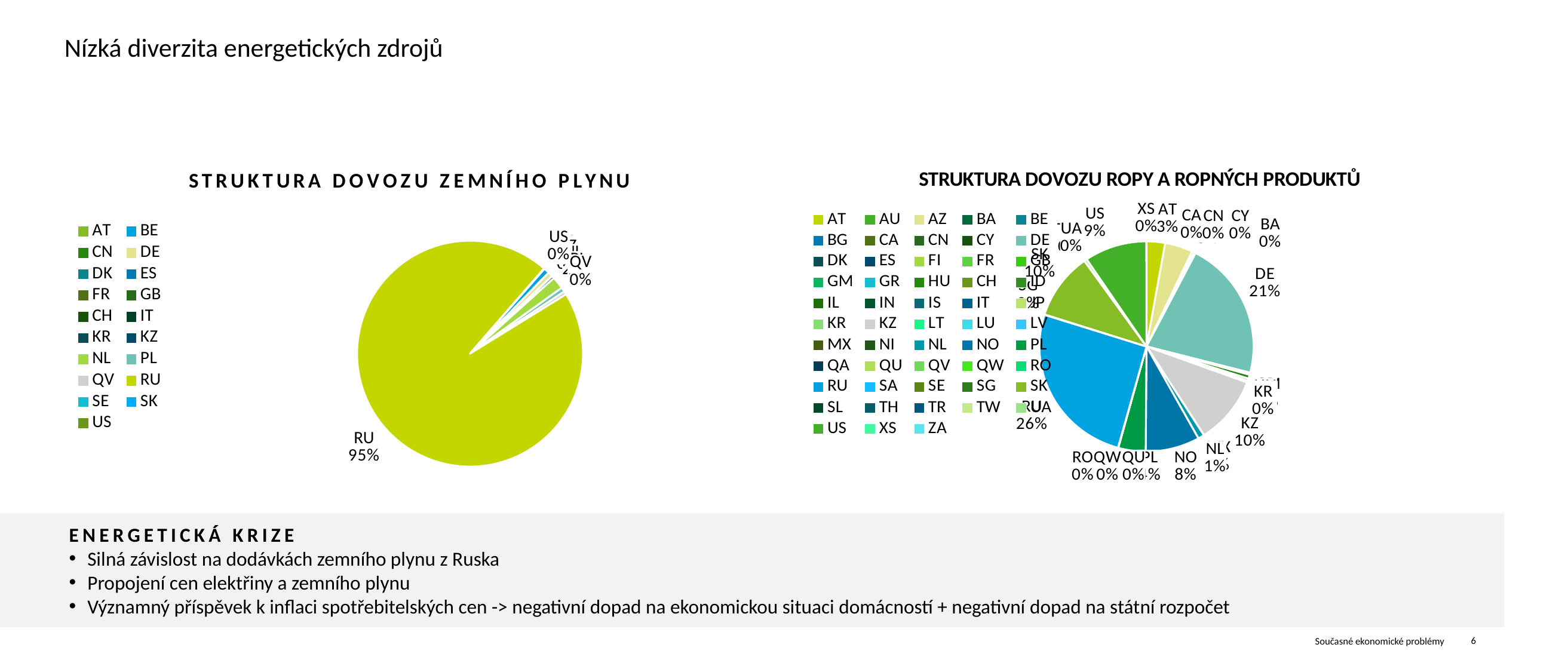
In the chart titled STRUKTURA DOVOZU ZEMNÍHO PLYNU, what share of the pie does RU have? 95% In the chart titled STRUKTURA DOVOZU ROPY A ROPNÝCH PRODUKTŮ, what share does US have? 9% What kind of chart is the left chart, STRUKTURA DOVOZU ZEMNÍHO PLYNU? Pie chart In the chart titled STRUKTURA DOVOZU ROPY A ROPNÝCH PRODUKTŮ, what share does NO have? 8% In the chart titled STRUKTURA DOVOZU ROPY A ROPNÝCH PRODUKTŮ, what share does DE have? 21% How many entries does the legend of the chart STRUKTURA DOVOZU ZEMNÍHO PLYNU list? 19 In the chart titled STRUKTURA DOVOZU ROPY A ROPNÝCH PRODUKTŮ, what share does RU have? 26% In the chart titled STRUKTURA DOVOZU ROPY A ROPNÝCH PRODUKTŮ, which has the larger share, DE or KZ? DE In the chart titled STRUKTURA DOVOZU ROPY A ROPNÝCH PRODUKTŮ, what share does KZ have? 10% In the chart titled STRUKTURA DOVOZU ROPY A ROPNÝCH PRODUKTŮ, how many percentage points larger is RU's share than DE's share? 5 percentage points In the chart titled STRUKTURA DOVOZU ZEMNÍHO PLYNU, which category has the largest slice? RU In the chart titled STRUKTURA DOVOZU ROPY A ROPNÝCH PRODUKTŮ, which category has the largest slice? RU